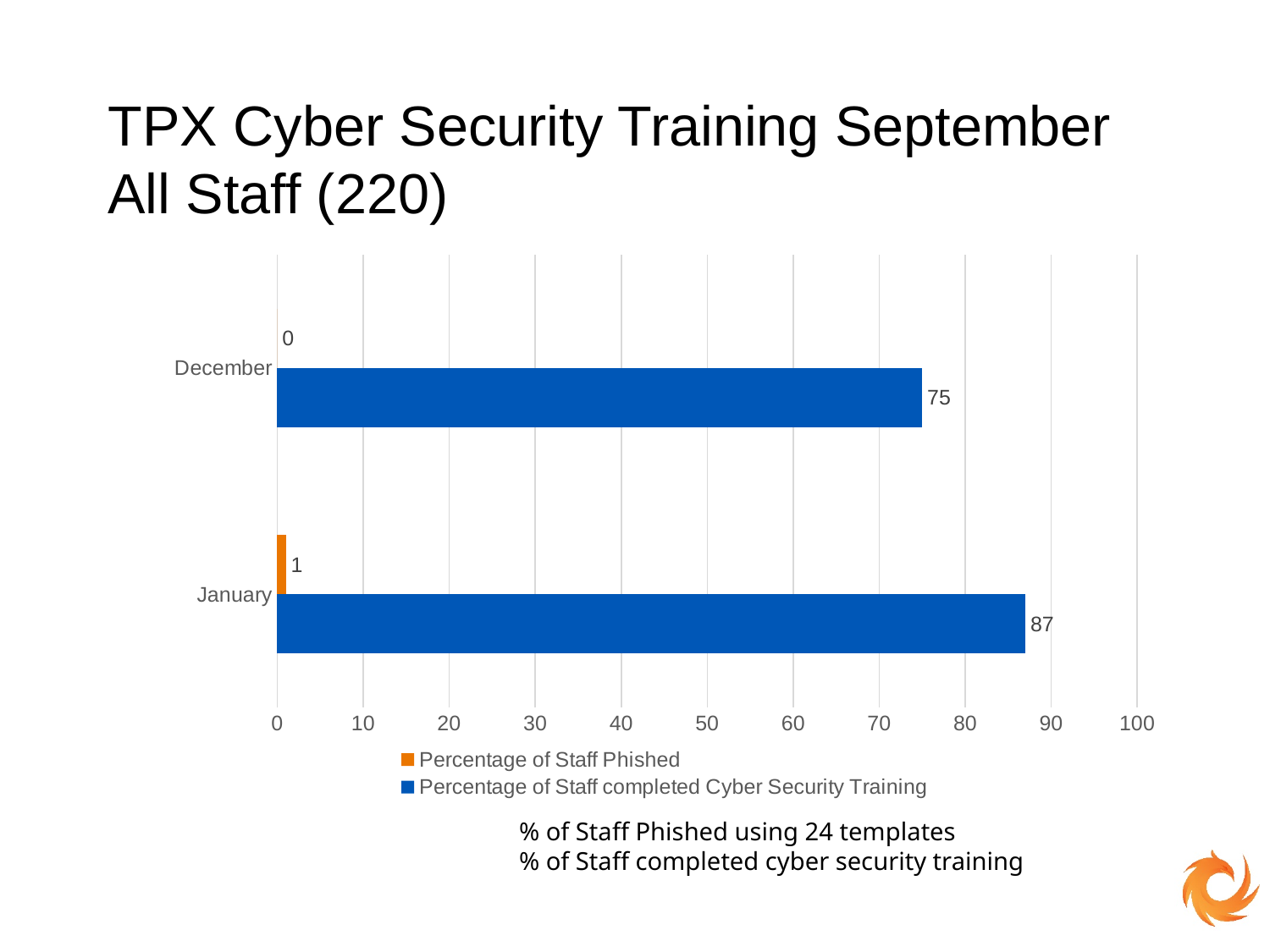
Which month has the higher Percentage of Staff completed Cyber Security Training? January Which month has the lower Percentage of Staff Phished? December What is the Percentage of Staff Phished for December? 0 What is the difference between the Percentage of Staff completed Cyber Security Training for January and December? 12 Is the Percentage of Staff completed Cyber Security Training for December greater or less than 70? greater What is the Percentage of Staff completed Cyber Security Training for January? 87 How many months are shown on the chart? 2 Which series is shown in orange? Percentage of Staff Phished What kind of chart is shown on the slide? Bar chart What is the Percentage of Staff completed Cyber Security Training for December? 75 How many series does the legend list? 2 What is the Percentage of Staff Phished for January? 1